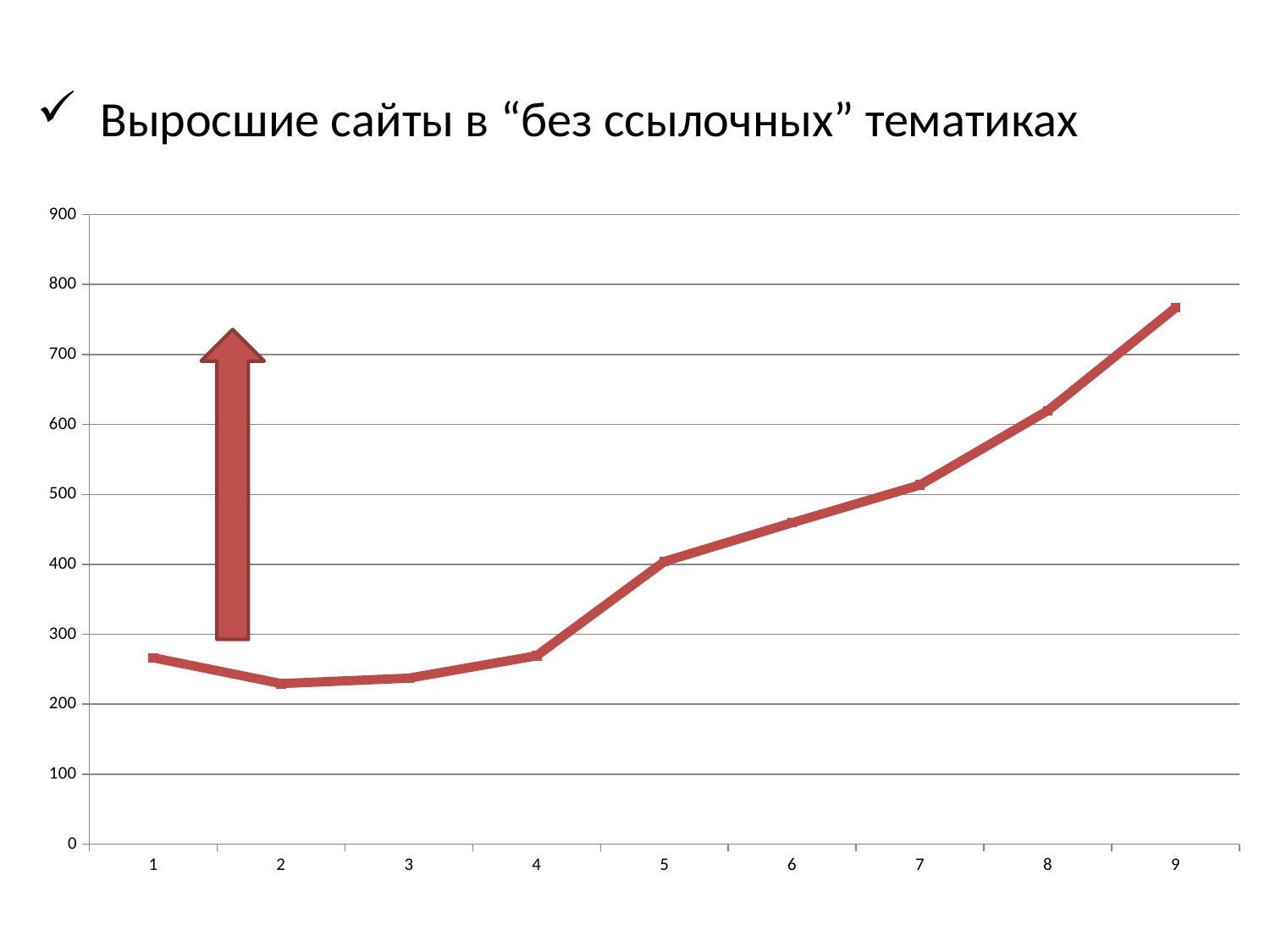
At which x-axis category does the line reach its highest value? 9 Which has the larger value, x = 5 or x = 4? 5 Is the value at x = 1 greater or less than 200? greater Which has the larger value, x = 1 or x = 9? 9 Is the value at x = 2 greater or less than 300? less What is the title text shown above the chart? Выросшие сайты в “без ссылочных” тематиках How many data points are plotted on the line? 9 What kind of chart is shown on the slide? line chart Do the values generally rise or fall from x = 4 to x = 9? rise Is the value at x = 9 greater or less than 700? greater